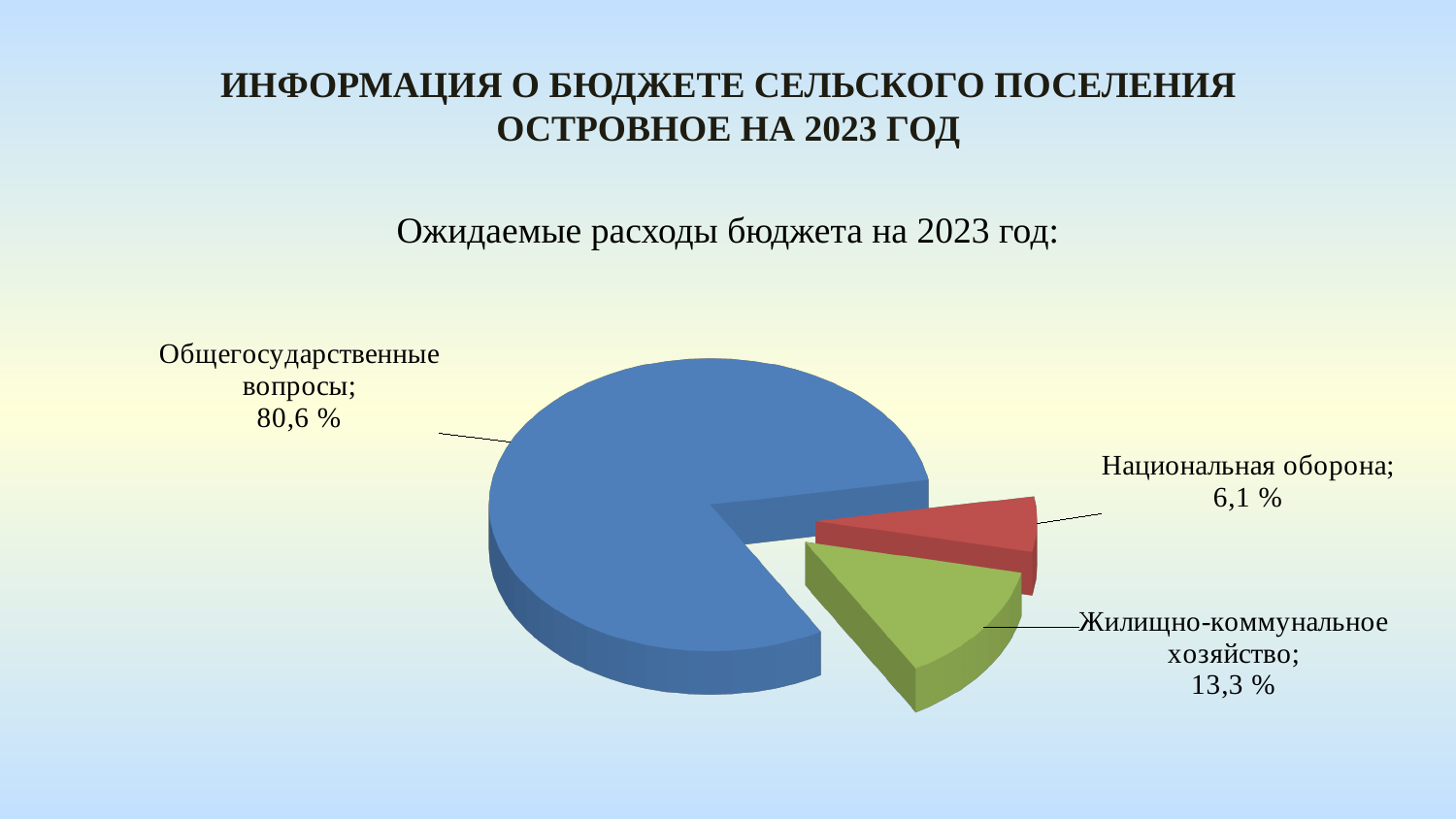
What is the title of the chart? Ожидаемые расходы бюджета на 2023 год: What share of the pie does Национальная оборона have? 6,1 % What is the difference in percentage points between Общегосударственные вопросы and Жилищно-коммунальное хозяйство? 67,3 What is the difference in percentage points between Жилищно-коммунальное хозяйство and Национальная оборона? 7,2 Which category has the smallest slice of the pie? Национальная оборона How many slices does the pie chart have? 3 Which category has the largest slice of the pie? Общегосударственные вопросы Which is larger: the share for Жилищно-коммунальное хозяйство or for Национальная оборона? Жилищно-коммунальное хозяйство What colour is the slice for Национальная оборона? Red What share of the pie does Жилищно-коммунальное хозяйство have? 13,3 % What kind of chart is shown on the slide? Pie chart What share of the pie does Общегосударственные вопросы have? 80,6 %